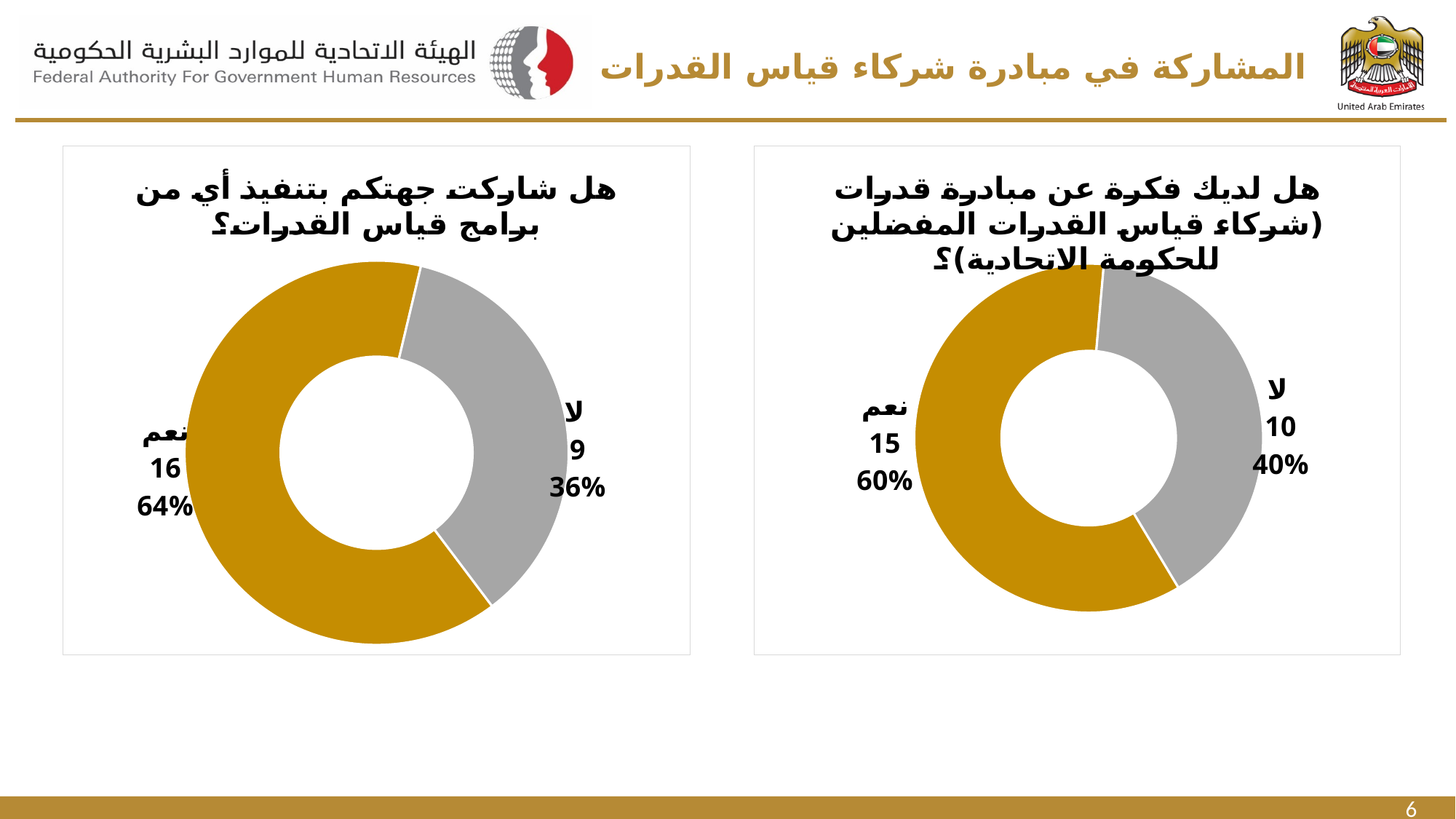
In the right chart, what colour is the slice for نعم? Gold/orange In the left chart, what is the total of the two counts shown? 25 What type of chart is shown on the left side of the slide? Donut (pie) chart In the left chart, which category has the larger share, نعم or لا? نعم In the right chart, which category has the smallest share? لا In the left chart (هل شاركت جهتكم بتنفيذ أي من برامج قياس القدرات؟), what percentage is shown for لا? 36% In the right chart (هل لديك فكرة عن مبادرة قدرات...؟), what percentage is shown for نعم? 60% In the right chart (هل لديك فكرة عن مبادرة قدرات...؟), what is the count for لا? 10 In the right chart, what is the total of the two counts shown? 25 How many categories does each donut chart on the slide show? 2 In the left chart (هل شاركت جهتكم بتنفيذ أي من برامج قياس القدرات؟), what is the count for نعم? 16 In the left chart, what is the difference between the counts for نعم and لا? 7